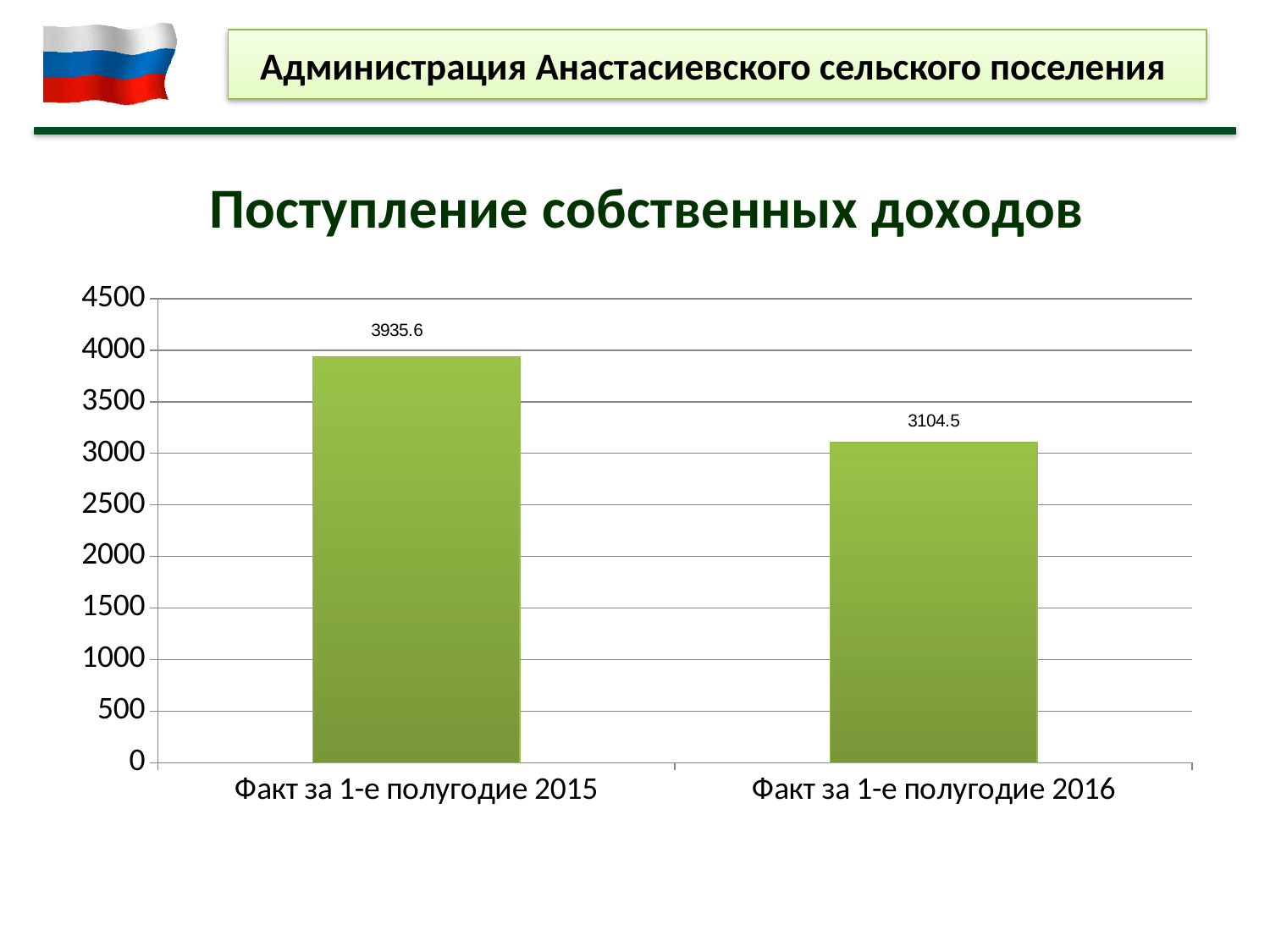
What is the title of the chart? Поступление собственных доходов What is the value for Факт за 1-е полугодие 2015? 3935.6 What is the value for Факт за 1-е полугодие 2016? 3104.5 Which is larger: the value for Факт за 1-е полугодие 2015 or for Факт за 1-е полугодие 2016? Факт за 1-е полугодие 2015 Do the values rise or fall from 2015 to 2016 along the x axis? fall What is the difference between the values for Факт за 1-е полугодие 2015 and Факт за 1-е полугодие 2016? 831.1 Which category has the highest value? Факт за 1-е полугодие 2015 Is the value for Факт за 1-е полугодие 2015 greater or less than 3500? greater How many categories are shown in the chart? 2 Which category has the lowest value? Факт за 1-е полугодие 2016 Is the value for Факт за 1-е полугодие 2016 greater or less than 3500? less What kind of chart is shown on the slide? bar chart